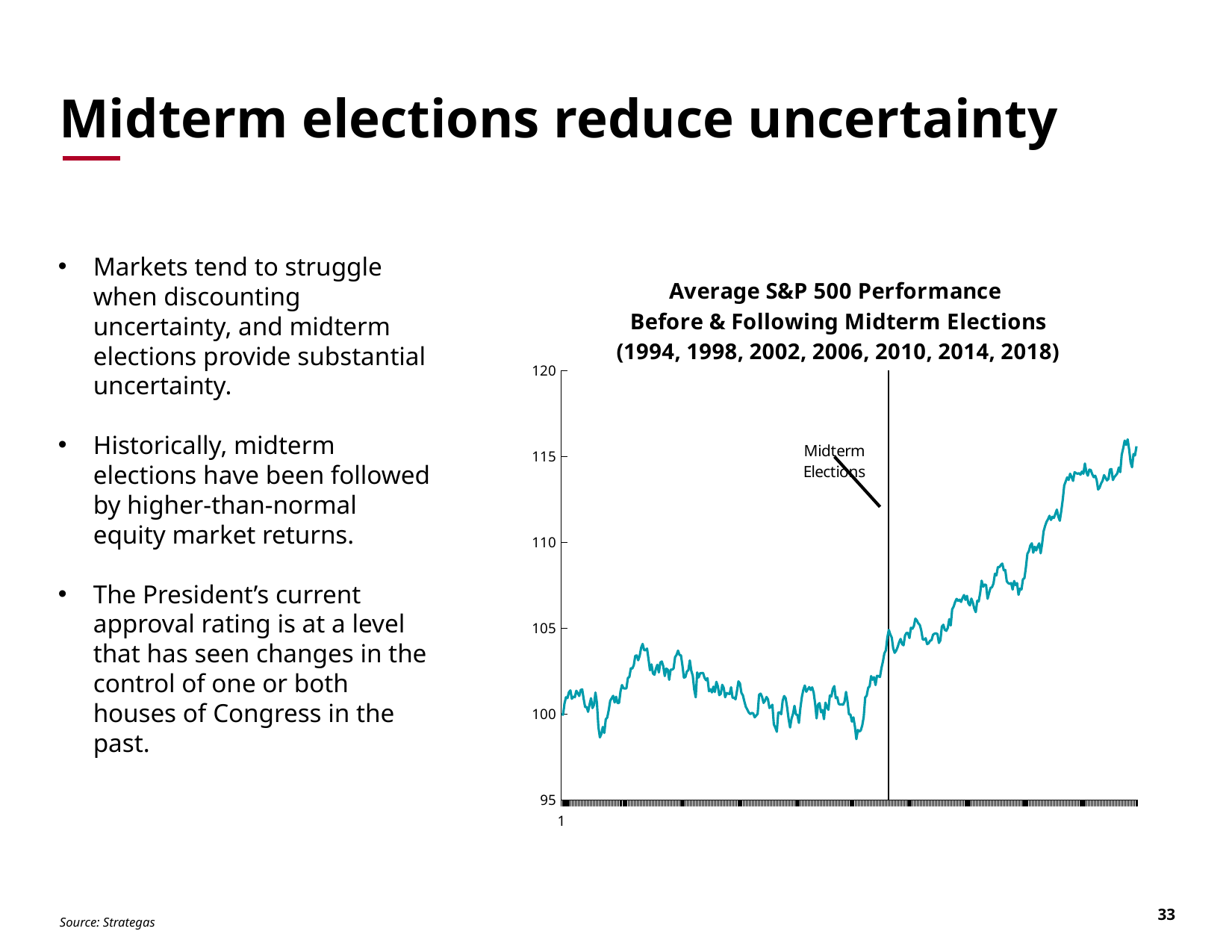
Which is larger, the value at the start of the line or the value at the end of the line? the value at the end What is the title of the chart? Average S&P 500 Performance Before & Following Midterm Elections (1994, 1998, 2002, 2006, 2010, 2014, 2018) Does the line rise or fall after the Midterm Elections vertical line? rise Is the lowest point of the line greater or less than 100? less What kind of chart is shown on the slide? line chart What does the annotation next to the vertical line in the chart say? Midterm Elections What is the lowest value shown on the y axis? 95 Is the value of the line at the Midterm Elections vertical line greater or less than 110? less How many midterm election years are listed in the chart title? 7 Is the value of the line at the Midterm Elections vertical line greater or less than 100? greater